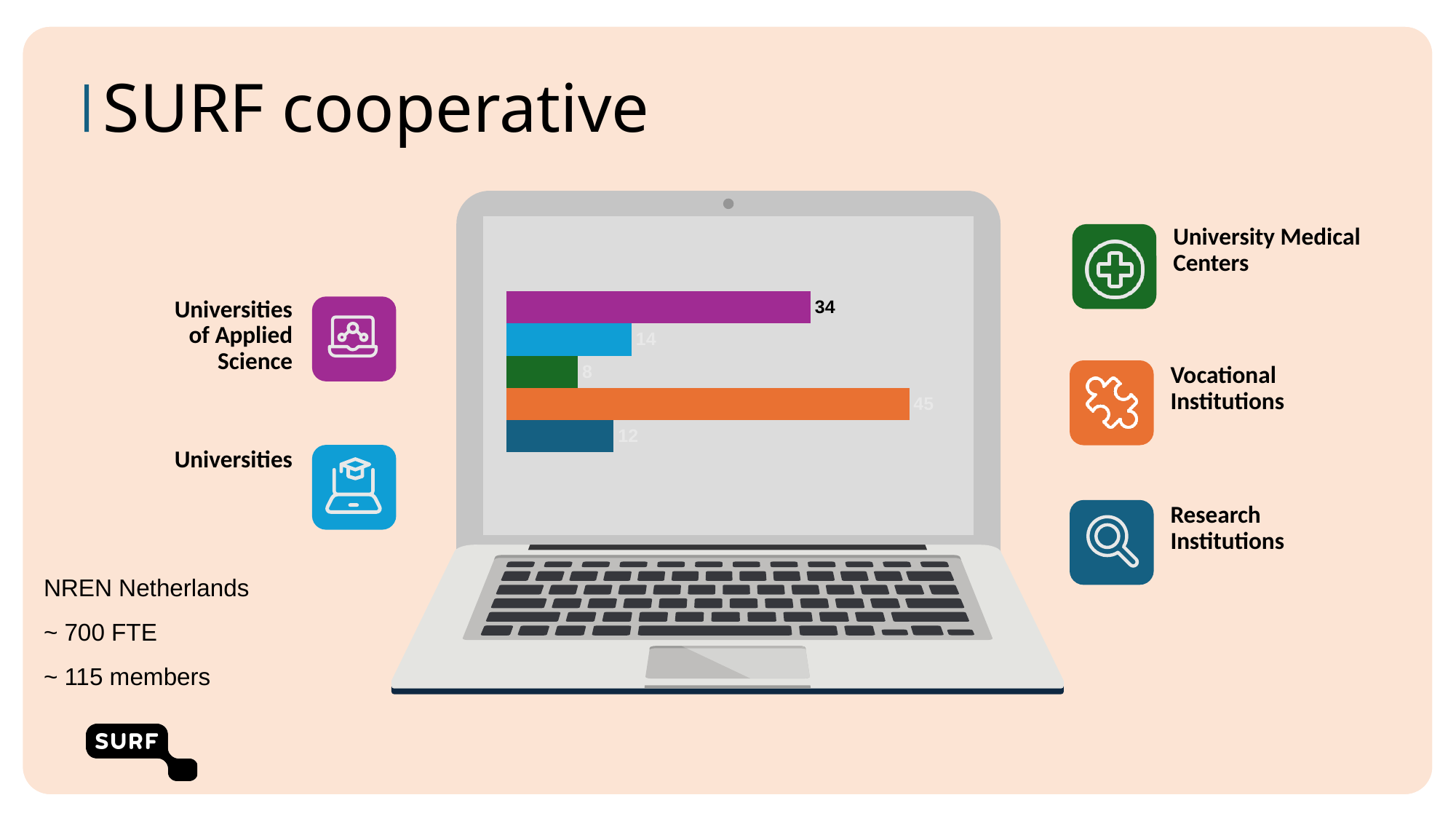
What is the value of the purple bar (Universities of Applied Science)? 34 Which category has the highest value in the chart? Vocational Institutions What is the value of the orange bar (Vocational Institutions)? 45 Which is larger, the value for Universities or the value for Research Institutions? Universities What is the value of the green bar (University Medical Centers)? 8 Which category has the lowest value in the chart? University Medical Centers How many bars does the chart show? 5 What is the value of the dark blue bar (Research Institutions)? 12 What kind of chart is shown on the laptop screen? bar chart What is the difference between the values for Vocational Institutions and Universities of Applied Science? 11 What is the value of the light blue bar (Universities)? 14 What is the total of all five bar values in the chart? 113